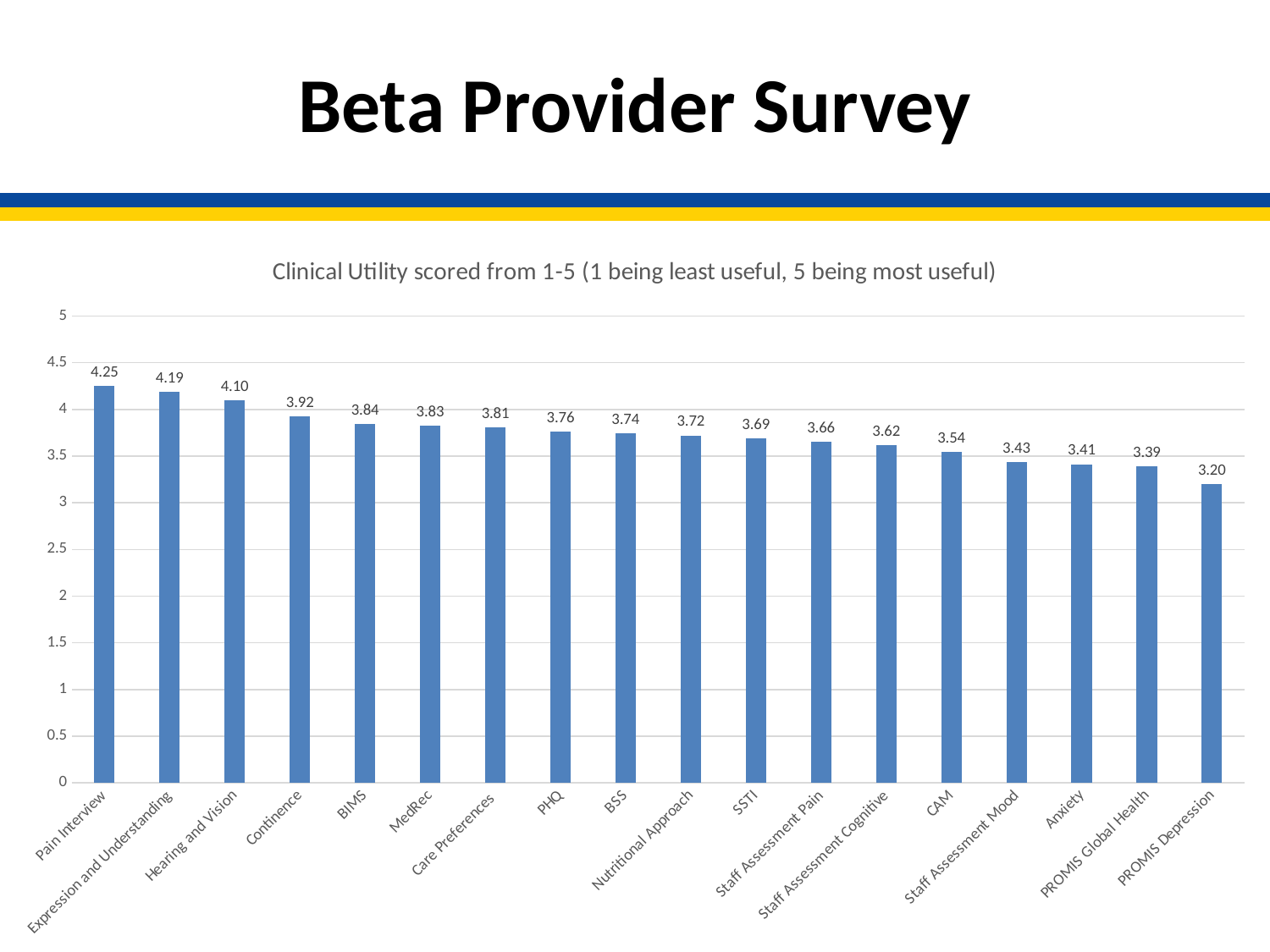
What is the clinical utility score for BIMS? 3.84 What is the clinical utility score for Pain Interview? 4.25 What is the title of the chart? Clinical Utility scored from 1-5 (1 being least useful, 5 being most useful) How many categories are shown in the chart? 18 Which category has the highest clinical utility score? Pain Interview What is the difference between the scores for Pain Interview and PROMIS Depression? 1.05 What is the difference between the scores for Continence and Anxiety? 0.51 Which category has the lowest clinical utility score? PROMIS Depression Which has a higher score, Hearing and Vision or SSTI? Hearing and Vision What kind of chart is shown on the slide? Bar chart Do the values rise or fall from left to right along the x axis? Fall What is the clinical utility score for CAM? 3.54